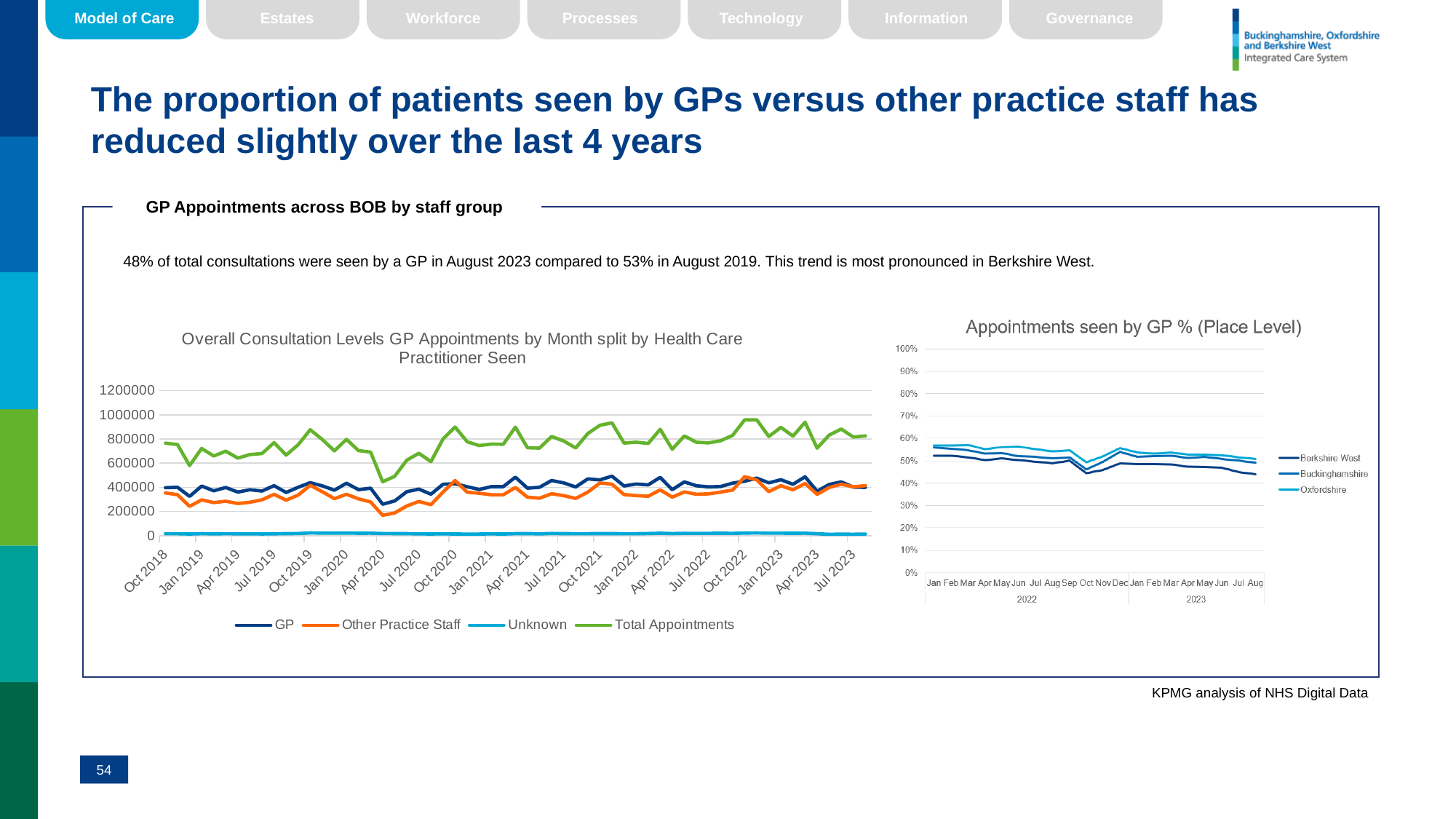
What is the title of the right chart on the slide? Appointments seen by GP % (Place Level) What type of chart is the left chart titled 'Overall Consultation Levels GP Appointments by Month split by Health Care Practitioner Seen'? Line chart In the left chart (Overall Consultation Levels), which is larger in Jan 2019: GP or Other Practice Staff? GP In the left chart (Overall Consultation Levels), is the value for Total Appointments in Apr 2020 greater or less than 600000? less In the left chart (Overall Consultation Levels), is the value for GP in Apr 2020 greater or less than 400000? less In the left chart (Overall Consultation Levels), which series stays lowest across the whole period? Unknown In the right chart 'Appointments seen by GP % (Place Level)', does the Berkshire West line rise or fall from Jan 2022 to Aug 2023? Fall How many series does the legend of the right chart 'Appointments seen by GP % (Place Level)' list? 3 In the right chart 'Appointments seen by GP % (Place Level)', is the value for Berkshire West in Aug 2023 greater or less than 50%? less In the right chart 'Appointments seen by GP % (Place Level)', which place has the lowest value in Aug 2023? Berkshire West How many series does the legend of the left chart (Overall Consultation Levels) list? 4